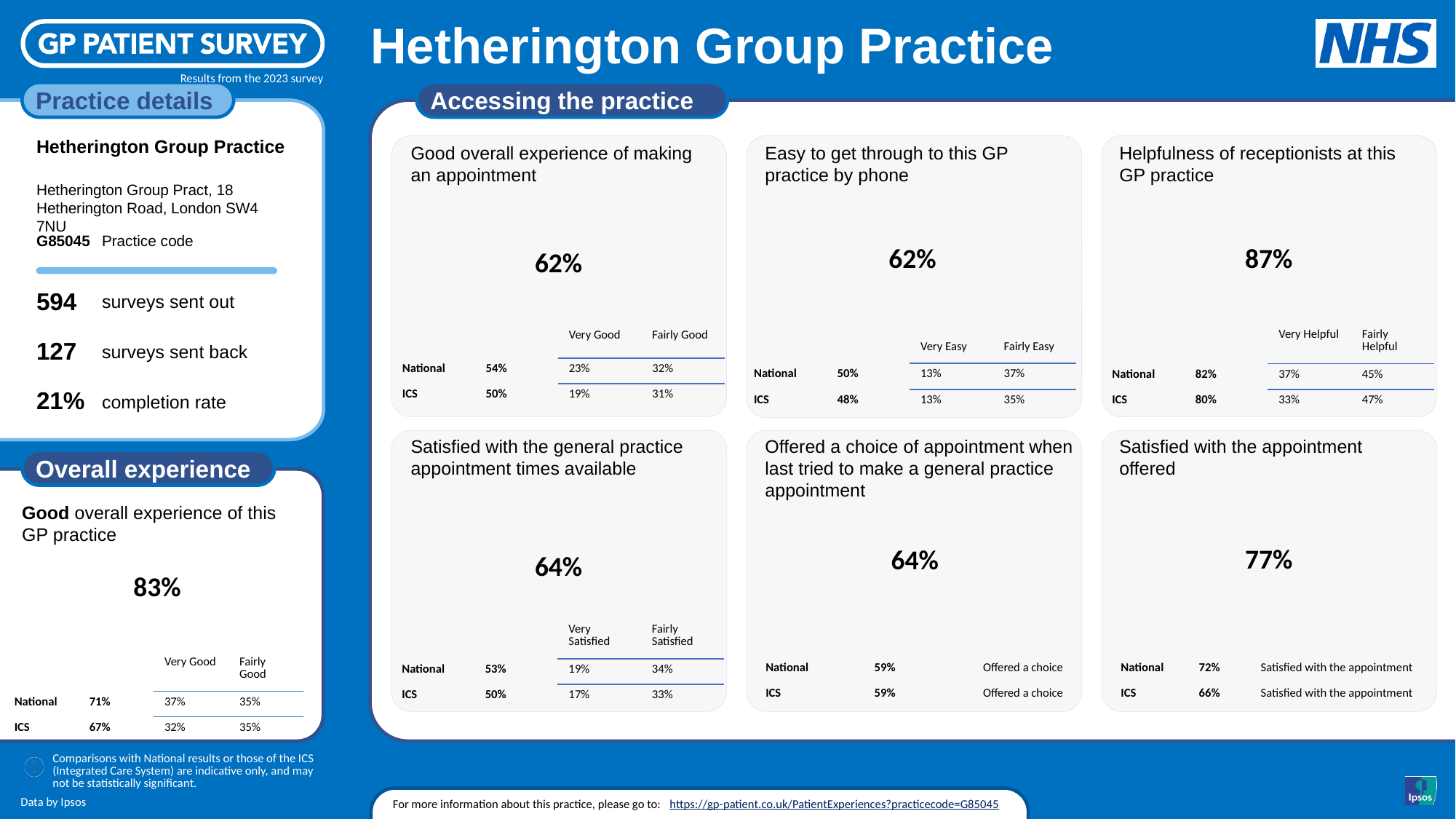
Among the six 'Accessing the practice' panels, which has the highest practice percentage? Helpfulness of receptionists at this GP practice In the 'Offered a choice of appointment' panel, what is the difference between the practice's 64% and the ICS 59%? 5% Among the six 'Accessing the practice' panels, which has the lowest practice percentage? Good overall experience of making an appointment (62%) and Easy to get through to this GP practice by phone (62%) In the 'Satisfied with the general practice appointment times available' panel, which is larger: the National value or the ICS value? National In the 'Overall experience' section, what is the National value for Very Good? 37% What are the two comparison rows listed in each panel's table? National and ICS How many panels are shown in the 'Accessing the practice' section? 6 In the 'Satisfied with the appointment offered' panel, what is the difference between the practice's 77% and the National 72%? 5% In the 'Helpfulness of receptionists at this GP practice' panel, what is the National value? 82% In the 'Overall experience' section, what is the practice's percentage for good overall experience of this GP practice? 83% In the 'Good overall experience of making an appointment' panel, what is the practice's headline percentage? 62% In the 'Easy to get through to this GP practice by phone' panel, what is the ICS value for Fairly Easy? 35%